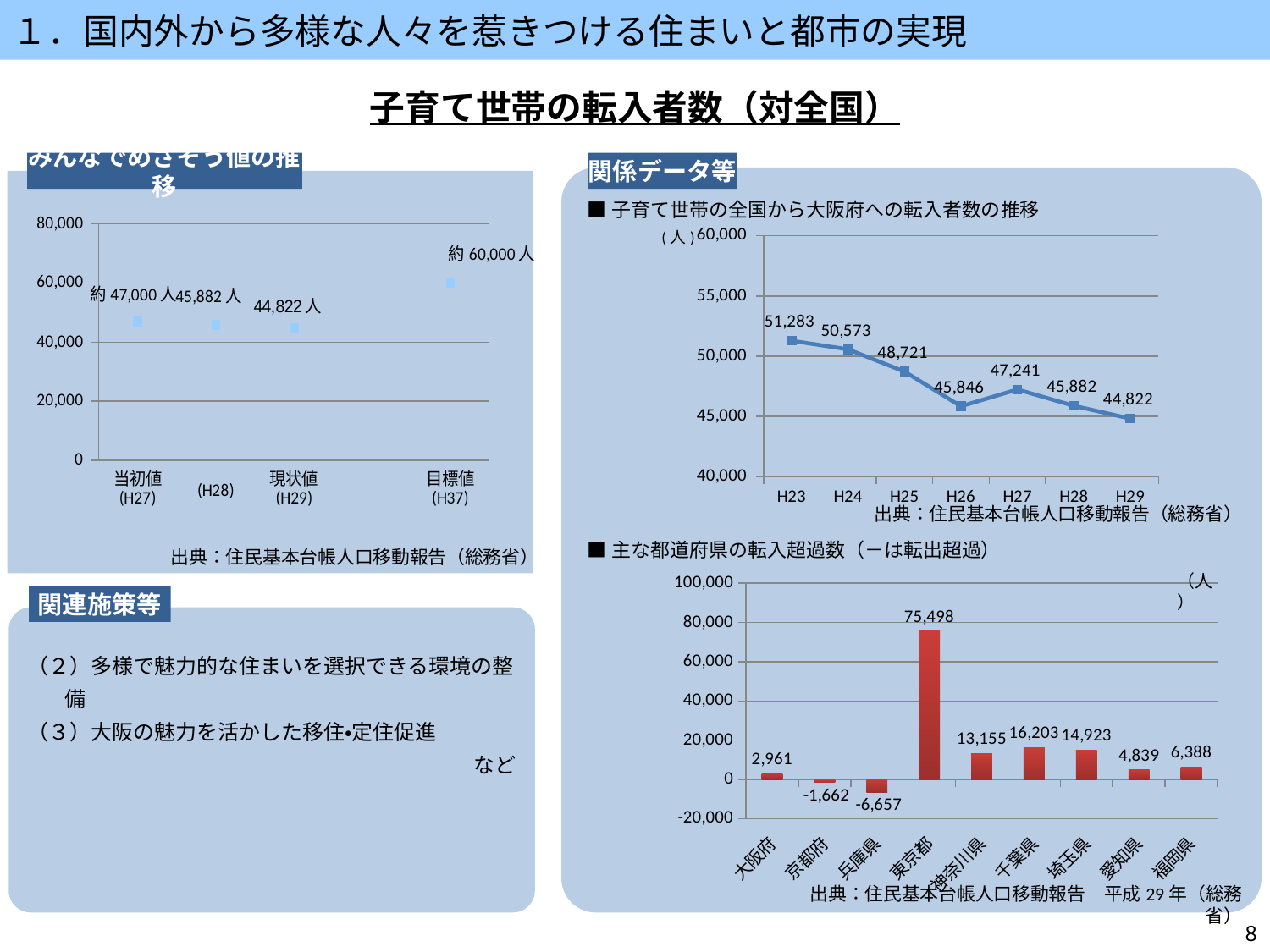
In the bar chart titled 主な都道府県の転入超過数, what is the difference between the values for 千葉県 and 埼玉県? 1,280 In the line chart titled 子育て世帯の全国から大阪府への転入者数の推移, which year has the highest value? H23 In the bar chart titled 主な都道府県の転入超過数, which prefecture has the lowest value? 兵庫県 In the bar chart titled 主な都道府県の転入超過数, which is larger, the value for 神奈川県 or the value for 埼玉県? 埼玉県 In the line chart titled 子育て世帯の全国から大阪府への転入者数の推移, do the values generally rise or fall from H23 to H29? fall In the bar chart titled 主な都道府県の転入超過数, what is the value for 東京都? 75,498 In the line chart titled 子育て世帯の全国から大阪府への転入者数の推移, which year has the lowest value? H29 In the bar chart titled 主な都道府県の転入超過数, how many prefectures are shown? 9 In the line chart titled 子育て世帯の全国から大阪府への転入者数の推移, what is the value for H26? 45,846 In the line chart titled 子育て世帯の全国から大阪府への転入者数の推移, how many years are plotted? 7 In the line chart titled 子育て世帯の全国から大阪府への転入者数の推移, what is the difference between the H23 value and the H29 value? 6,461 In the chart on the left of the slide (みんなでめざそう値の推移), what is the value for 現状値 (H29)? 44,822 人